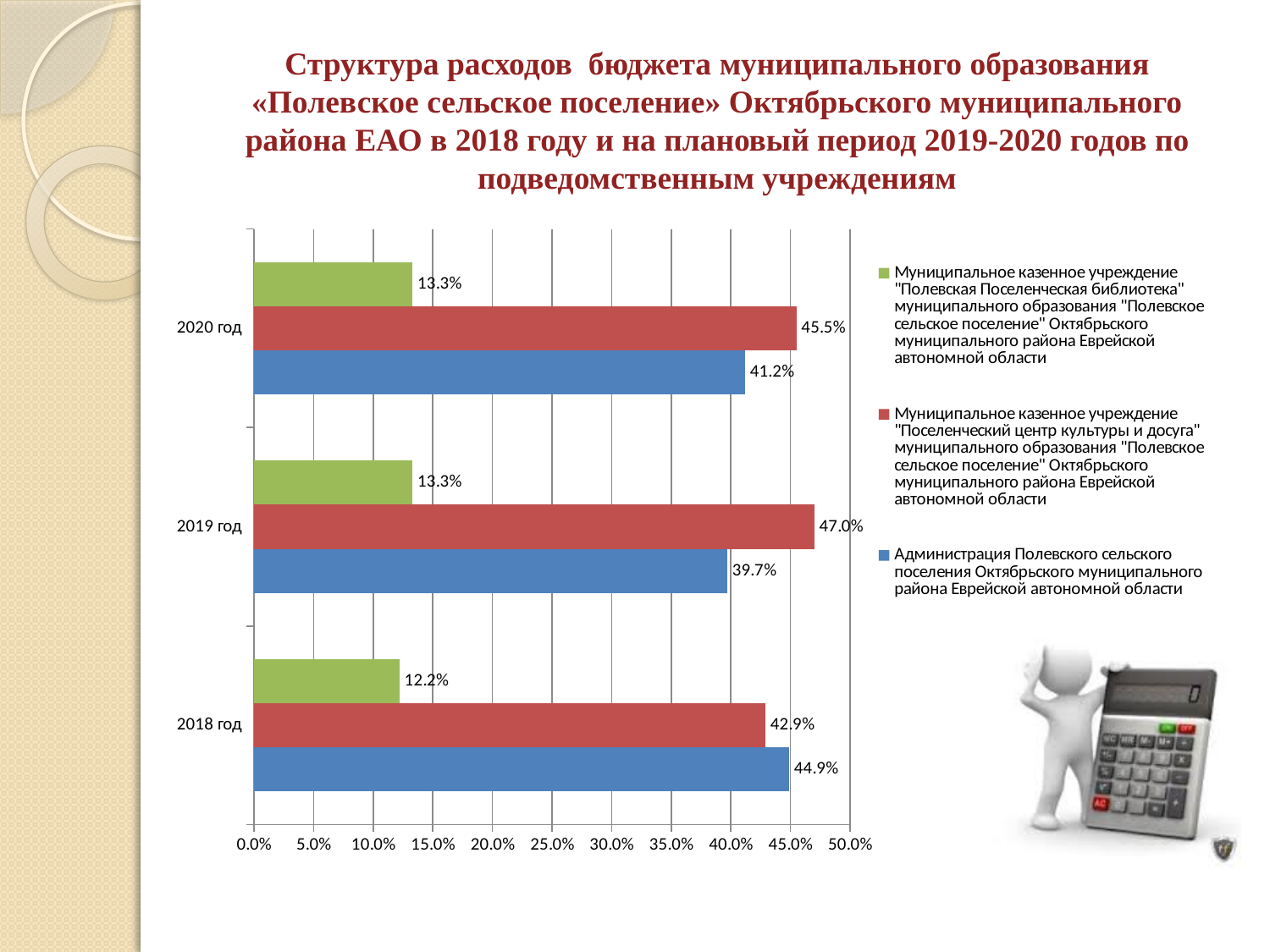
What is the value for the Администрация series in 2018 год? 44.9% What kind of chart is shown on the slide? bar chart How many years are shown on the chart? 3 Is the value for the Администрация series in 2019 год greater or less than 40.0%? less What is the value for the "Полевская Поселенческая библиотека" series in 2020 год? 13.3% In which year is the value for the "Поселенческий центр культуры и досуга" series highest? 2019 год In which year is the value for the "Полевская Поселенческая библиотека" series lowest? 2018 год What is the difference between the "Поселенческий центр культуры и досуга" value and the Администрация value in 2020 год? 4.3% What is the value for the "Поселенческий центр культуры и досуга" series in 2019 год? 47.0% In 2018 год, which is larger: the Администрация value or the "Поселенческий центр культуры и досуга" value? Администрация What is the value for the Администрация series in 2020 год? 41.2% How many series does the legend list? 3